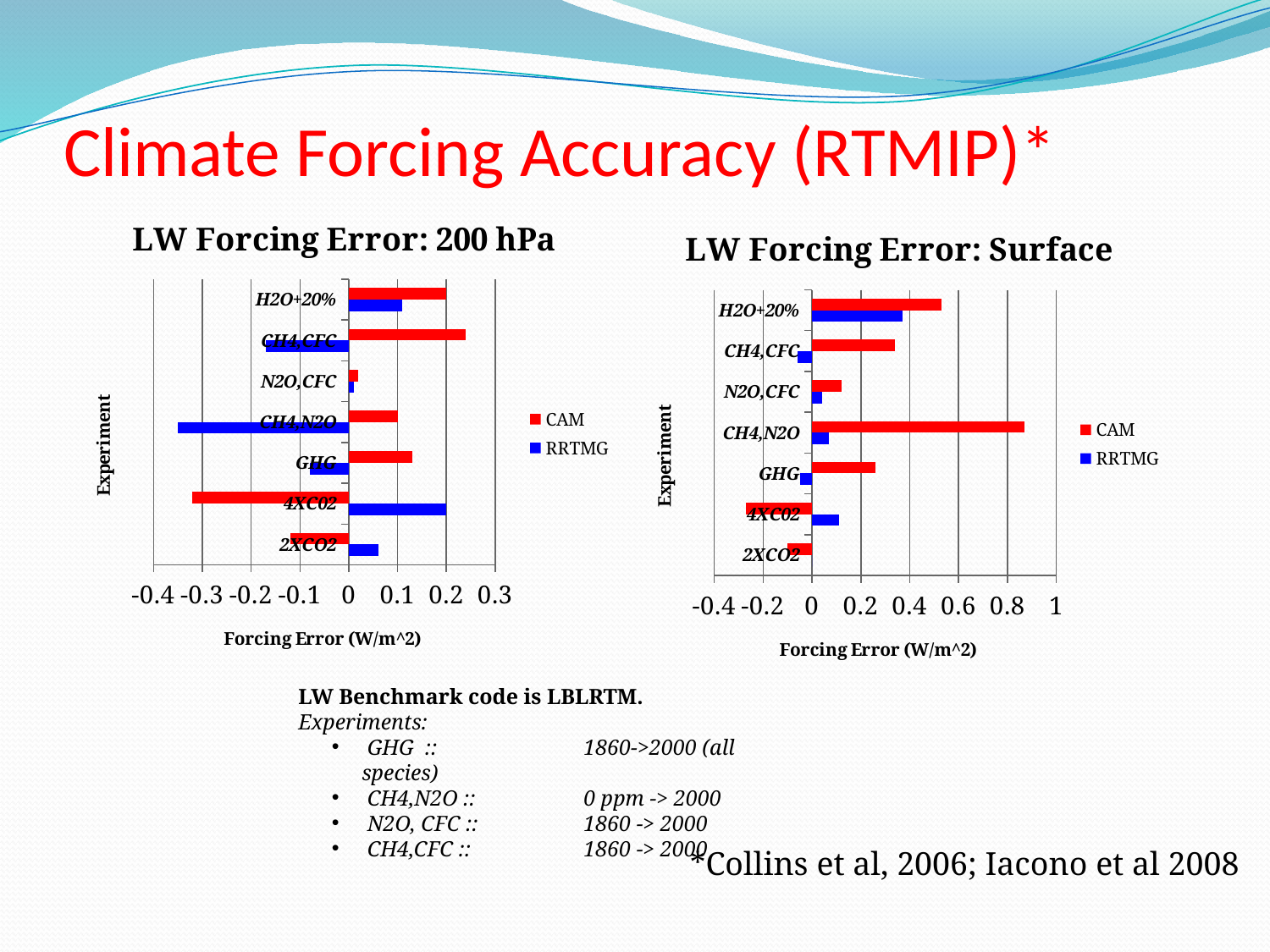
In the 'LW Forcing Error: Surface' chart, which is larger: the CAM value for H2O+20% or the CAM value for CH4,CFC? H2O+20% In the 'LW Forcing Error: 200 hPa' chart, which experiment has the highest RRTMG forcing error? 4XC02 What is the x-axis title of the 'LW Forcing Error: 200 hPa' chart? Forcing Error (W/m^2) What kind of chart is the 'LW Forcing Error: Surface' chart? Bar chart In the 'LW Forcing Error: 200 hPa' chart, which experiment has the lowest (most negative) RRTMG forcing error? CH4,N2O In the 'LW Forcing Error: Surface' chart, which experiment has the highest CAM forcing error? CH4,N2O In the 'LW Forcing Error: Surface' chart, is the CAM value for CH4,N2O greater or less than 0.8? greater In the 'LW Forcing Error: 200 hPa' chart, is the CAM value for 4XCO2 greater or less than -0.2? less In the 'LW Forcing Error: 200 hPa' chart, is the CAM value for CH4,CFC greater or less than 0.2? greater How many experiments are listed on the y axis of the 'LW Forcing Error: Surface' chart? 7 How many series does the legend of the 'LW Forcing Error: 200 hPa' chart list? 2